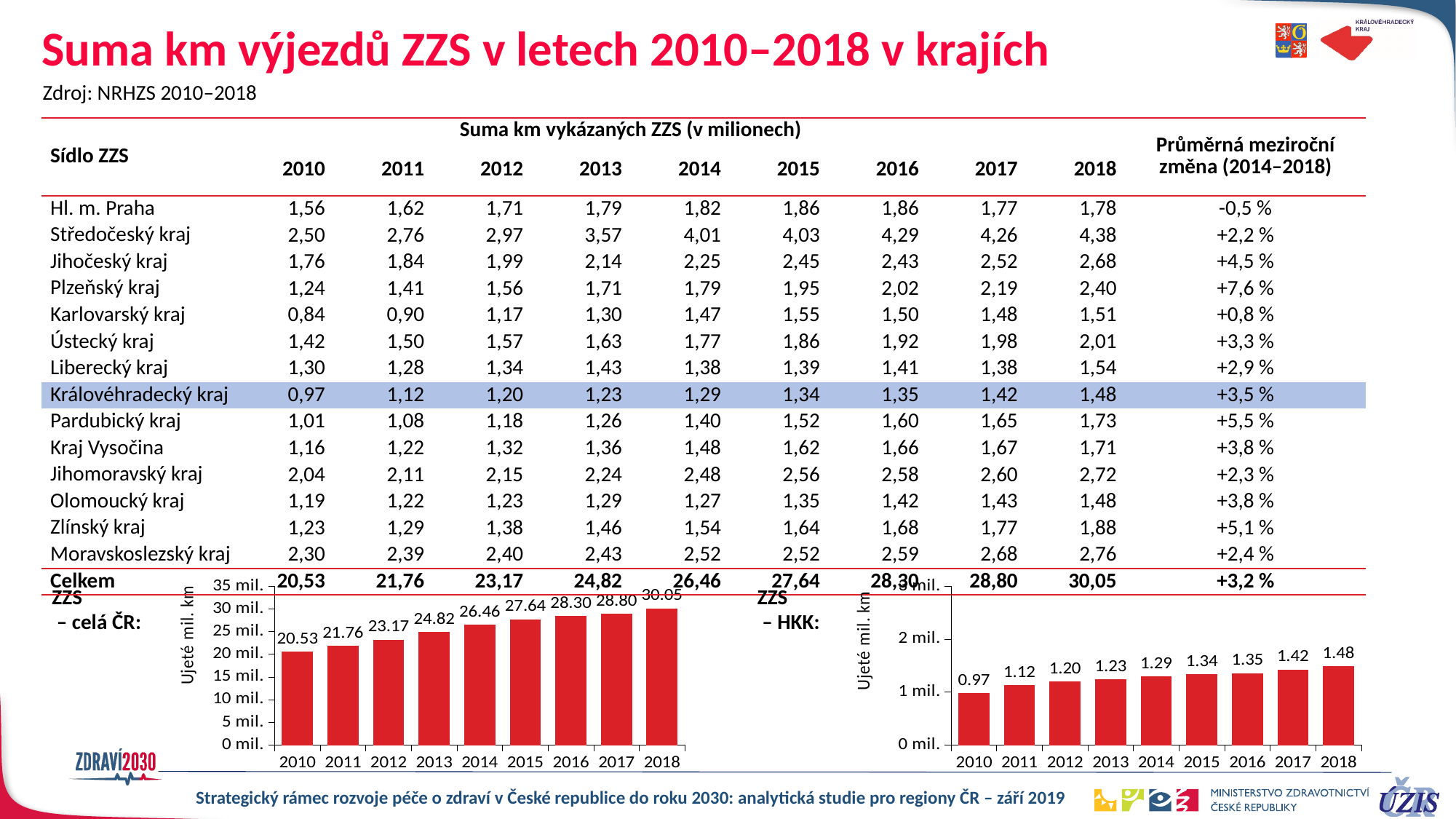
In the right chart (ZZS – HKK), which year has the lowest value? 2010 In the right chart (ZZS – HKK), what is the value for 2014? 1.29 In the right chart (ZZS – HKK), what is the difference between the values for 2017 and 2016? 0.07 In the left chart (ZZS – celá ČR), what is the value for 2010? 20.53 In the left chart (ZZS – celá ČR), is the value for 2014 greater or less than 25 mil.? greater In the left chart (ZZS – celá ČR), which year has the highest value? 2018 In the right chart (ZZS – HKK), do the values rise or fall from 2010 to 2018? rise In the left chart (ZZS – celá ČR), what is the value for 2018? 30.05 In the left chart (ZZS – celá ČR), what is the difference between the values for 2018 and 2010? 9.52 What kind of chart is the left chart (ZZS – celá ČR)? bar chart In the right chart (ZZS – HKK), which is larger, the value for 2012 or the value for 2015? 2015 How many years are shown on the x axis of the right chart (ZZS – HKK)? 9